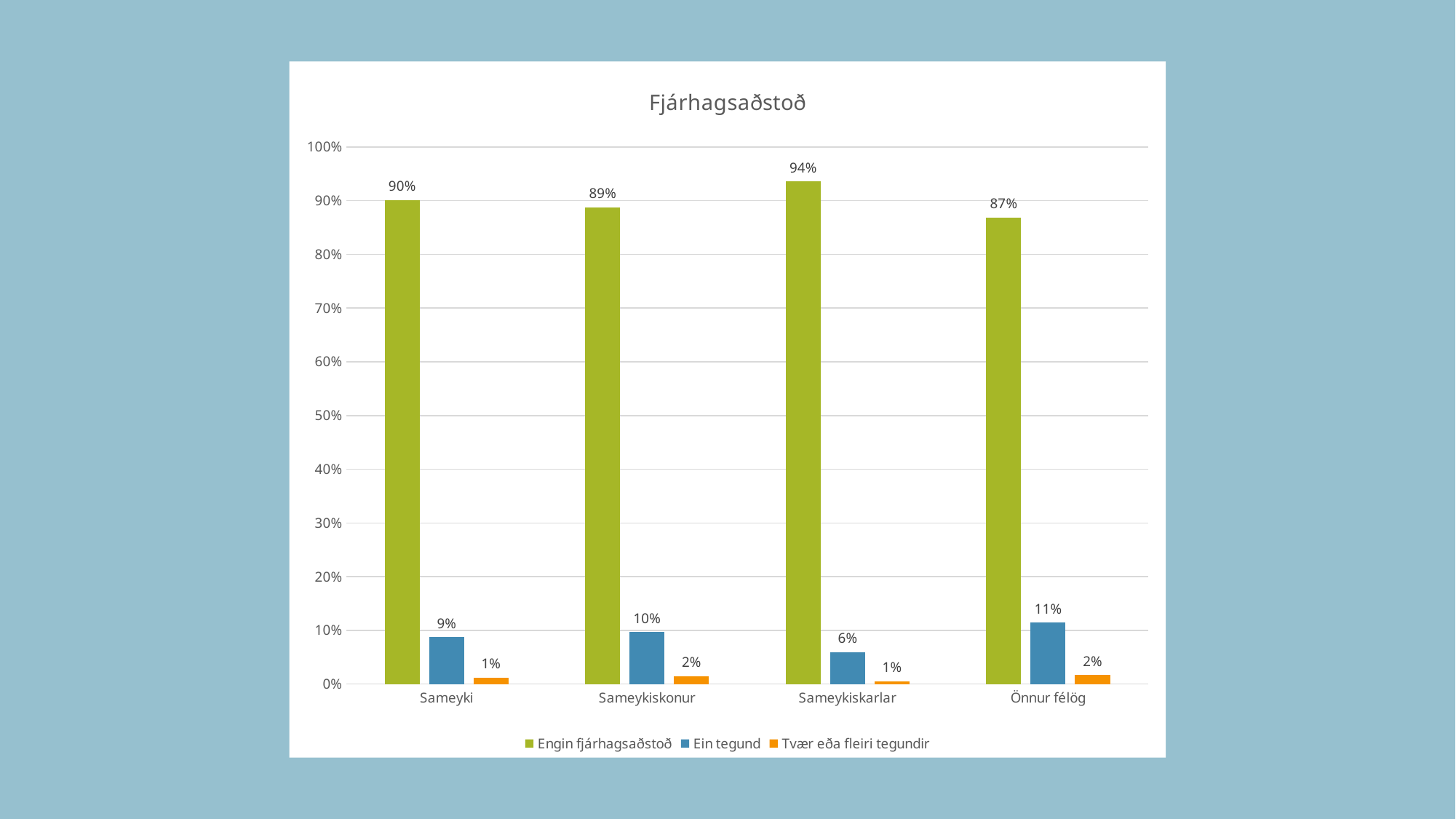
How many categories are shown on the x axis? 4 Which category has the highest value for Engin fjárhagsaðstoð? Sameykiskarlar What is the value of Engin fjárhagsaðstoð for Sameykiskarlar? 94% What is the title of the chart? Fjárhagsaðstoð What is the value of Tvær eða fleiri tegundir for Sameykiskonur? 2% What is the value of Ein tegund for Önnur félög? 11% What kind of chart is shown on the slide? bar chart What is the difference between the Engin fjárhagsaðstoð values for Sameykiskarlar and Önnur félög? 7% How many series does the legend list? 3 Which category has the lowest value for Ein tegund? Sameykiskarlar Which is larger: Ein tegund for Sameyki or Ein tegund for Önnur félög? Önnur félög Is the value of Engin fjárhagsaðstoð for Önnur félög greater or less than 90%? less